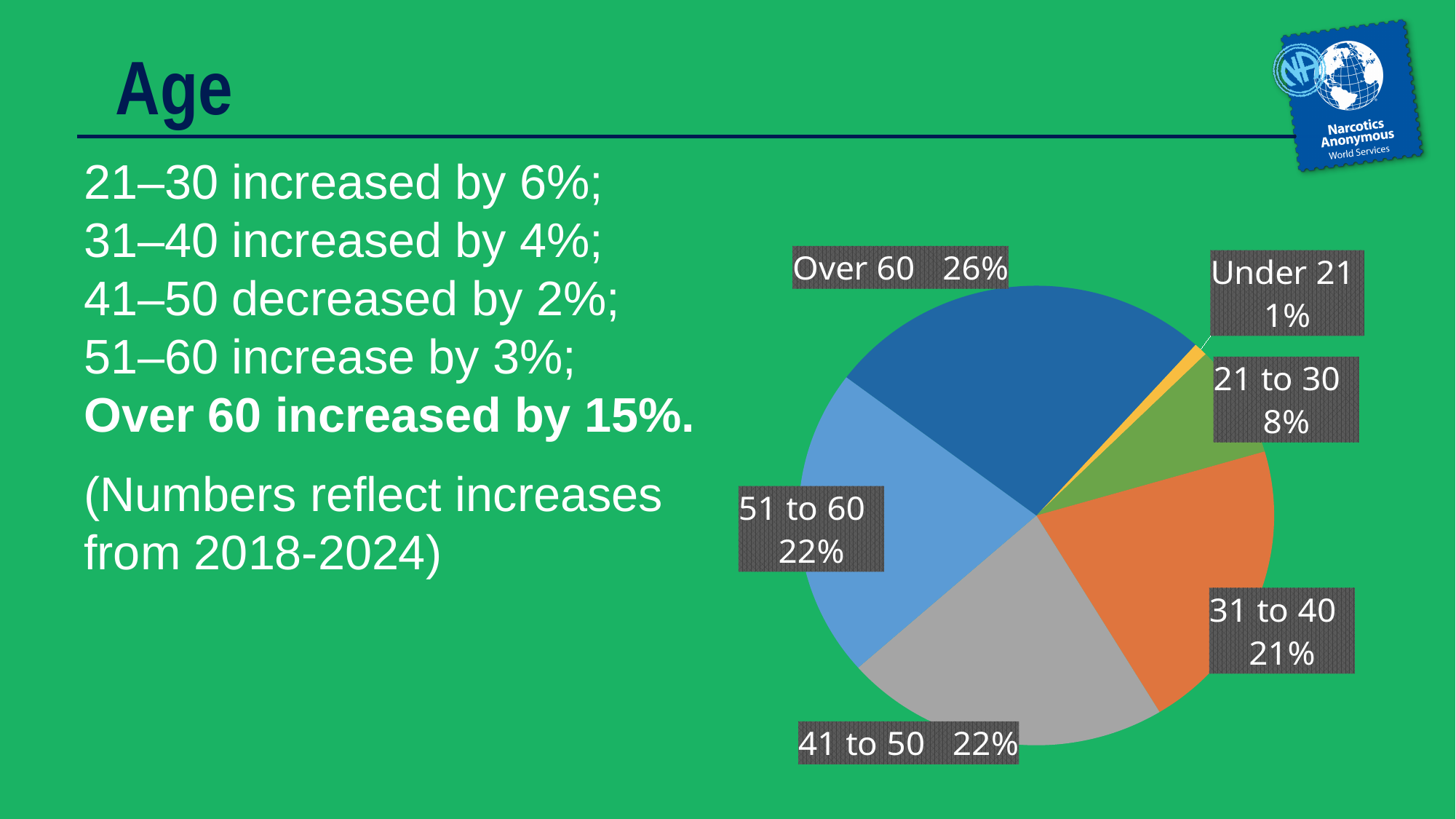
How many slices does the pie chart have? 6 Which age group has the smallest slice of the pie? Under 21 What is the combined share of the '41 to 50' and '51 to 60' slices? 44% What colour is the 'Over 60' slice of the pie? dark blue Which is larger, the '21 to 30' slice or the '51 to 60' slice? 51 to 60 What is the difference in percentage points between the 'Over 60' slice and the '31 to 40' slice? 5% What is the value shown for the 'Under 21' slice? 1% Which age group has the largest slice of the pie? Over 60 What is the value shown for the '31 to 40' slice? 21% What share of the pie does the 'Over 60' slice represent? 26% What kind of chart is shown on the slide? pie chart What is the value shown for the '21 to 30' slice? 8%